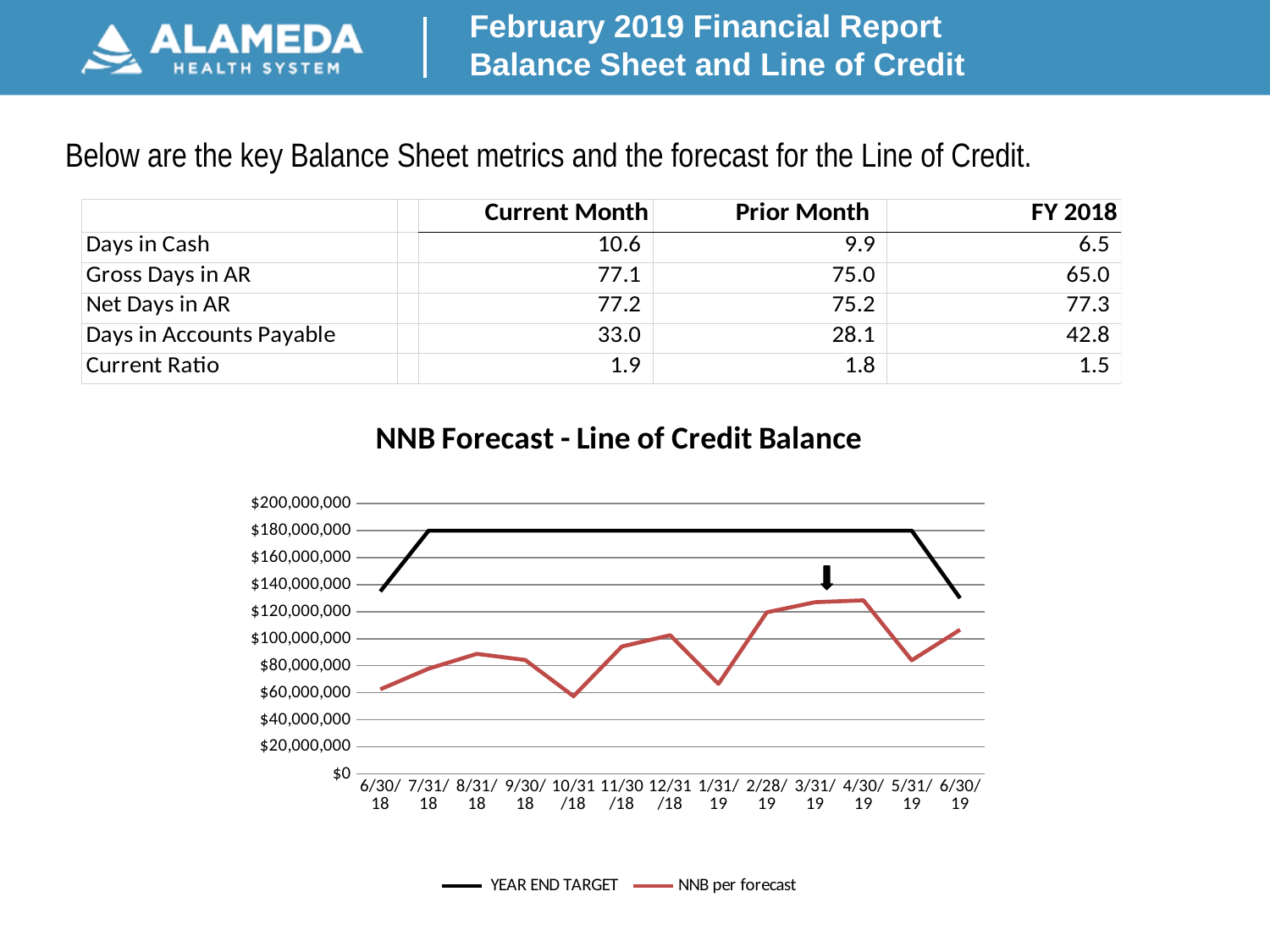
How many dates are shown along the x axis of the chart? 13 Which is larger for NNB per forecast: the value at 1/31/19 or the value at 2/28/19? 2/28/19 How many series does the chart's legend list? 2 Is the NNB per forecast value at 3/31/19 greater or less than $120,000,000? greater What is the title of the chart on the slide? NNB Forecast - Line of Credit Balance Does the NNB per forecast line rise or fall from 1/31/19 to 3/31/19? Rise What is the YEAR END TARGET value at 12/31/18? $180,000,000 Is the NNB per forecast value at 5/31/19 greater or less than $100,000,000? less Which colour is used for the NNB per forecast line? Red What kind of chart is shown on the slide? Line chart Is the YEAR END TARGET value at 6/30/18 greater or less than $140,000,000? less